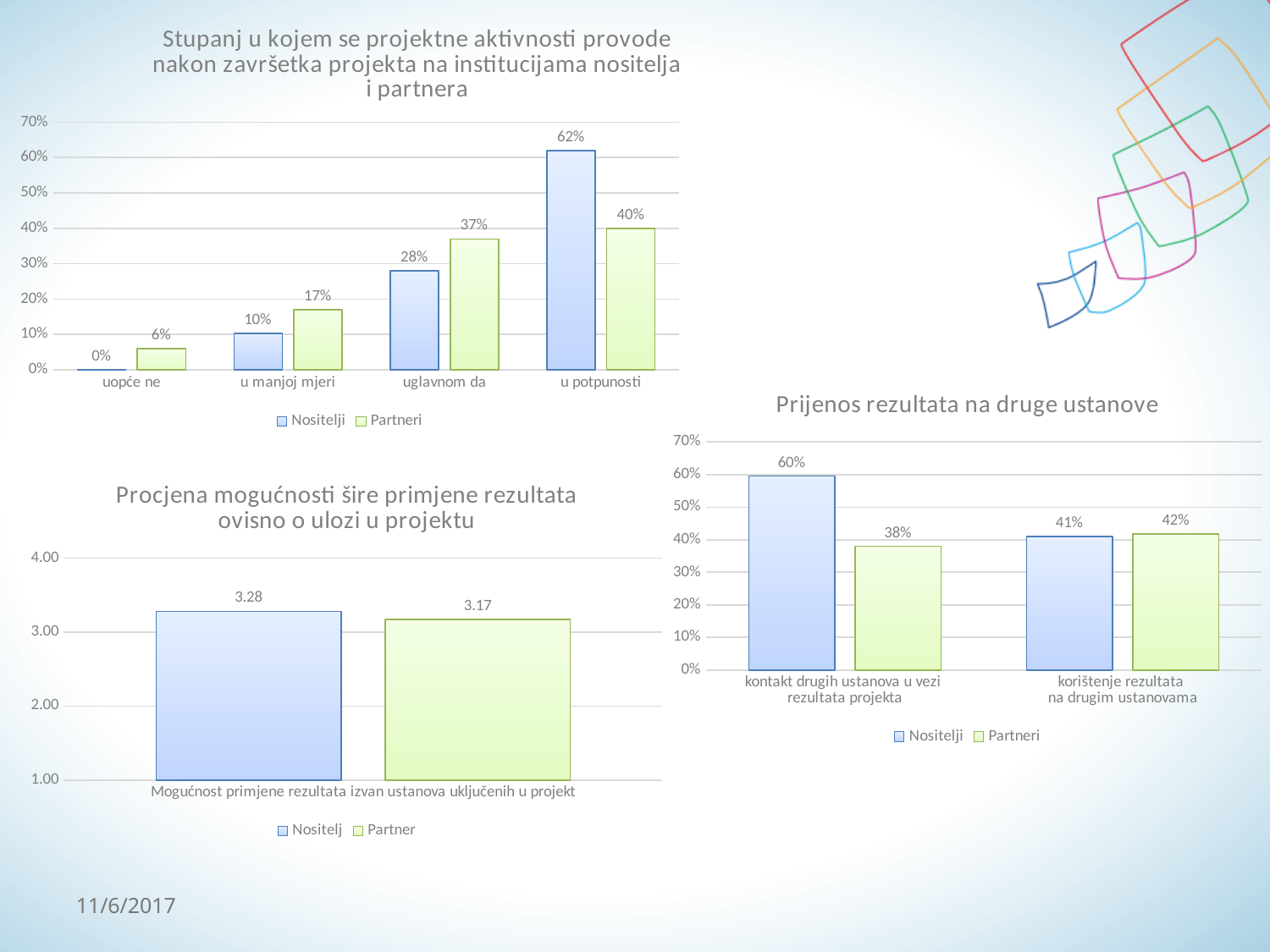
In the bottom-left chart 'Procjena mogućnosti šire primjene rezultata ovisno o ulozi u projektu', what is the value for Nositelj? 3.28 In the top-left chart 'Stupanj u kojem se projektne aktivnosti provode...', how many categories are shown on the x axis? 4 How many series does the legend of the right chart 'Prijenos rezultata na druge ustanove' list? 2 In the right chart 'Prijenos rezultata na druge ustanove', what is the difference between Nositelji and Partneri in 'kontakt drugih ustanova u vezi rezultata projekta'? 22% In the top-left chart 'Stupanj u kojem se projektne aktivnosti provode...', which category has the highest value for Partneri? u potpunosti What kind of chart is the bottom-left chart 'Procjena mogućnosti šire primjene rezultata ovisno o ulozi u projektu'? Bar chart In the top-left chart 'Stupanj u kojem se projektne aktivnosti provode...', which is larger in the 'uopće ne' category, Nositelji or Partneri? Partneri In the top-left chart 'Stupanj u kojem se projektne aktivnosti provode...', what is the value for Partneri in the 'u manjoj mjeri' category? 17% In the bottom-left chart 'Procjena mogućnosti šire primjene rezultata ovisno o ulozi u projektu', what is the difference between Nositelj and Partner? 0.11 In the top-left chart 'Stupanj u kojem se projektne aktivnosti provode...', what is the difference between Nositelji and Partneri in the 'uglavnom da' category? 9% In the top-left chart 'Stupanj u kojem se projektne aktivnosti provode nakon završetka projekta na institucijama nositelja i partnera', what is the value for Nositelji in the 'u potpunosti' category? 62% In the right chart 'Prijenos rezultata na druge ustanove', what is the value for Nositelji in 'kontakt drugih ustanova u vezi rezultata projekta'? 60%